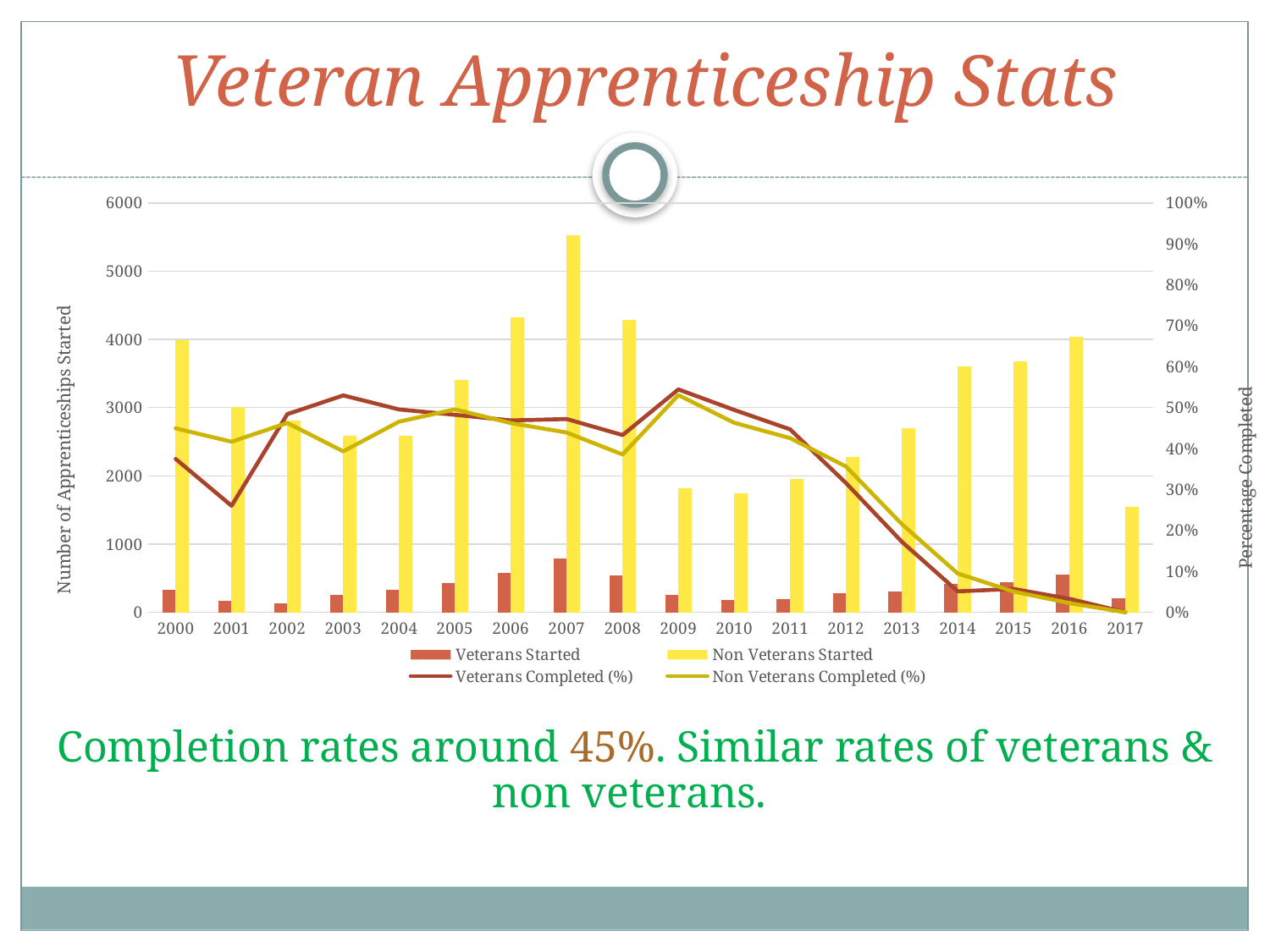
Is the value for Non Veterans Started in 2009 greater or less than 2000? less Which is larger, the Non Veterans Started bar for 2007 or for 2016? 2007 In which year is the Veterans Started bar the highest? 2007 Is the value for Veterans Started in 2007 greater or less than 1000? less How many series does the legend list? 4 In which year is the Non Veterans Started bar the lowest? 2017 In which year is the Non Veterans Started bar the highest? 2007 Does the Veterans Completed (%) line rise or fall from 2011 to 2017? fall Is the value for Non Veterans Started in 2007 greater or less than 5000? greater What is the label of the left vertical axis? Number of Apprenticeships Started What kind of chart is shown on the slide? A combined bar and line chart How many years are shown along the x axis? 18